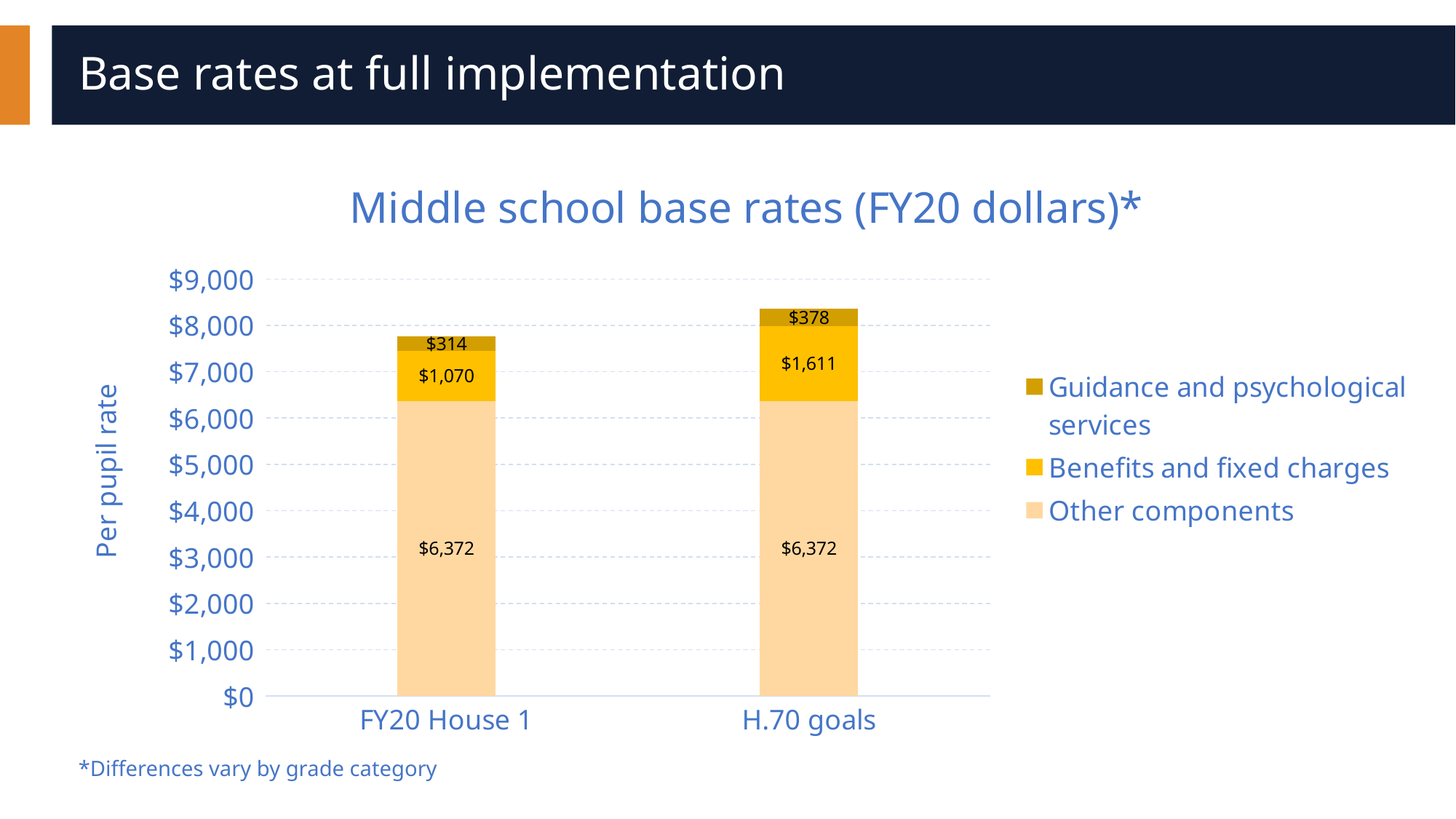
What is the value of Guidance and psychological services for H.70 goals? $378 What is the value of Guidance and psychological services for FY20 House 1? $314 How much larger is Benefits and fixed charges for H.70 goals than for FY20 House 1? $541 Which category has the higher total per pupil rate, FY20 House 1 or H.70 goals? H.70 goals What is the total per pupil rate for the FY20 House 1 bar? $7,756 Is the total for the H.70 goals bar greater or less than $8,000? greater How many series does the legend list? 3 What is the value of Benefits and fixed charges for FY20 House 1? $1,070 What is the difference in Guidance and psychological services between H.70 goals and FY20 House 1? $64 What is the value of Other components for H.70 goals? $6,372 What type of chart is shown on the slide? Stacked bar chart What is the total per pupil rate for the H.70 goals bar? $8,361